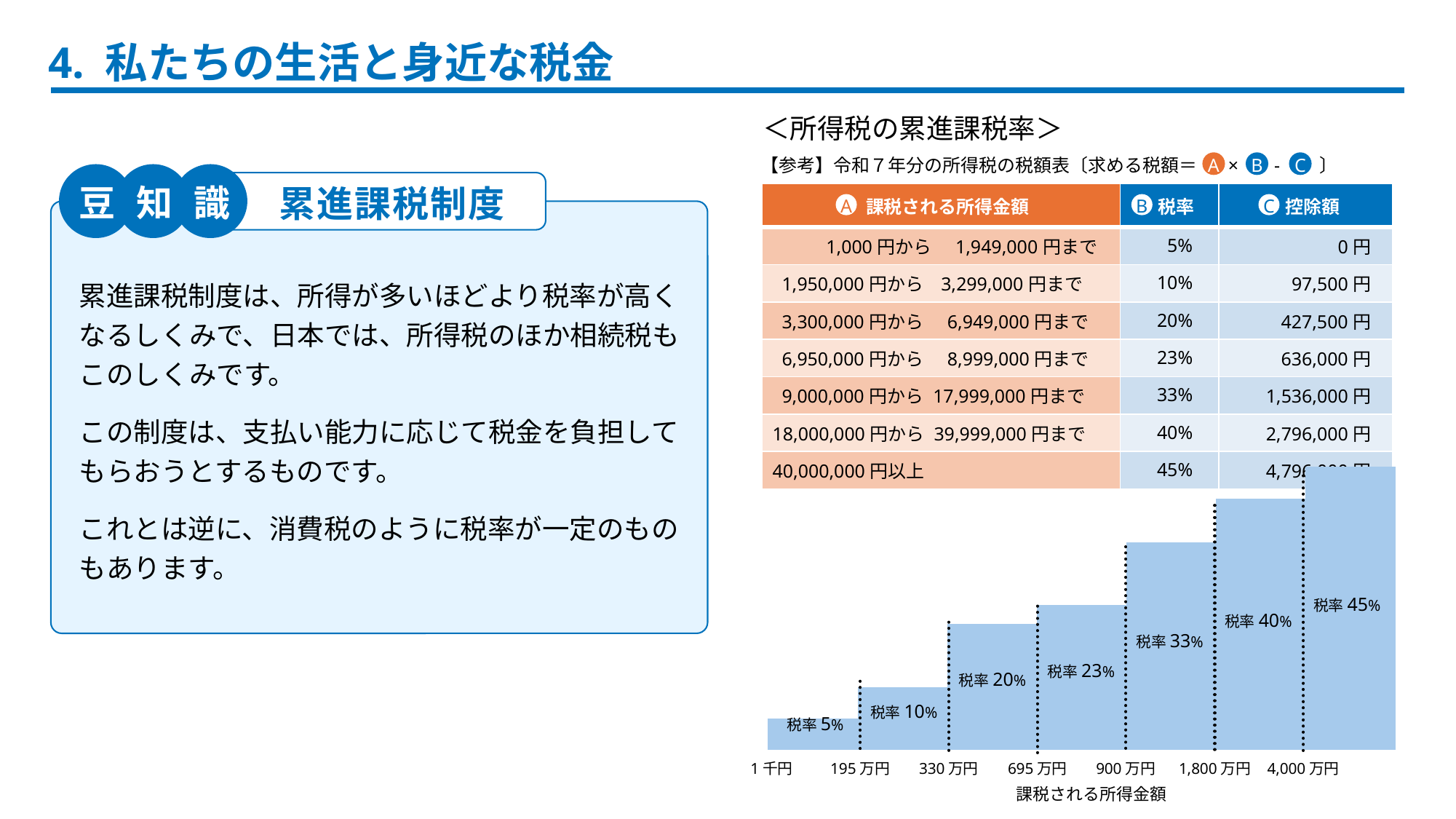
In the ＜所得税の累進課税率＞ chart, which income bracket has the highest tax rate? 4,000万円以上 (税率45%) In the ＜所得税の累進課税率＞ chart, what tax rate is labelled on the bar that starts at 900万円? 33% In the ＜所得税の累進課税率＞ chart, what tax rate is labelled on the bar that starts at 330万円? 20% In the ＜所得税の累進課税率＞ chart, what is the difference between the tax rate for the bracket starting at 1,800万円 and the bracket starting at 695万円? 17% In the ＜所得税の累進課税率＞ chart, what is the tax rate shown for the lowest income bracket (starting at 1千円)? 5% In the ＜所得税の累進課税率＞ chart, which income bracket has the lowest tax rate? 1千円から195万円 (税率5%) What is the x-axis label of the ＜所得税の累進課税率＞ chart? 課税される所得金額 In the ＜所得税の累進課税率＞ chart, do the tax rates rise or fall as the taxable income increases along the x axis? Rise What kind of chart is the ＜所得税の累進課税率＞ chart? Bar chart (step chart) How many tax-rate steps (bars) are shown in the ＜所得税の累進課税率＞ chart? 7 In the ＜所得税の累進課税率＞ chart, which is higher: the tax rate for the bracket starting at 195万円 or the bracket starting at 330万円? 330万円 (税率20%) In the ＜所得税の累進課税率＞ chart, what tax rate is labelled on the bar that starts at 4,000万円? 45%